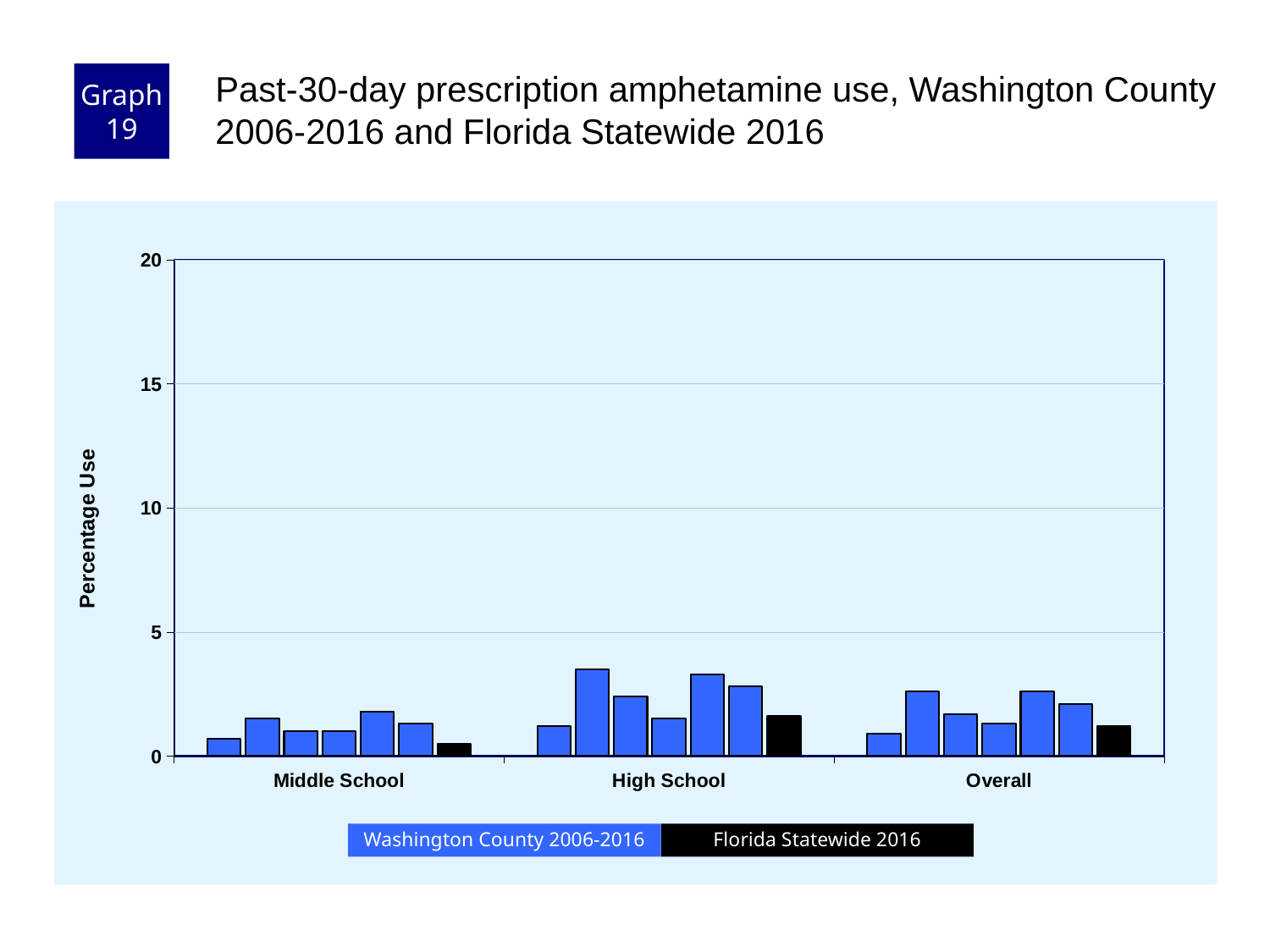
Is the Florida Statewide 2016 value for Middle School greater or less than 5? less What is the label on the y axis? Percentage Use Is the Florida Statewide 2016 value for High School greater or less than 5? less How many school-level categories are shown along the x axis? 3 Which school-level group has the lowest Florida Statewide 2016 value? Middle School What kind of chart is shown on the slide? bar chart Which is larger: the Florida Statewide 2016 value for Overall or for Middle School? Overall Is the tallest Washington County bar in the High School group greater or less than 5? less Which is larger: the Florida Statewide 2016 value for High School or for Middle School? High School What are the two series named in the legend? Washington County 2006-2016 and Florida Statewide 2016 How many series does the legend list? 2 Which school-level group contains the tallest bar on the chart? High School